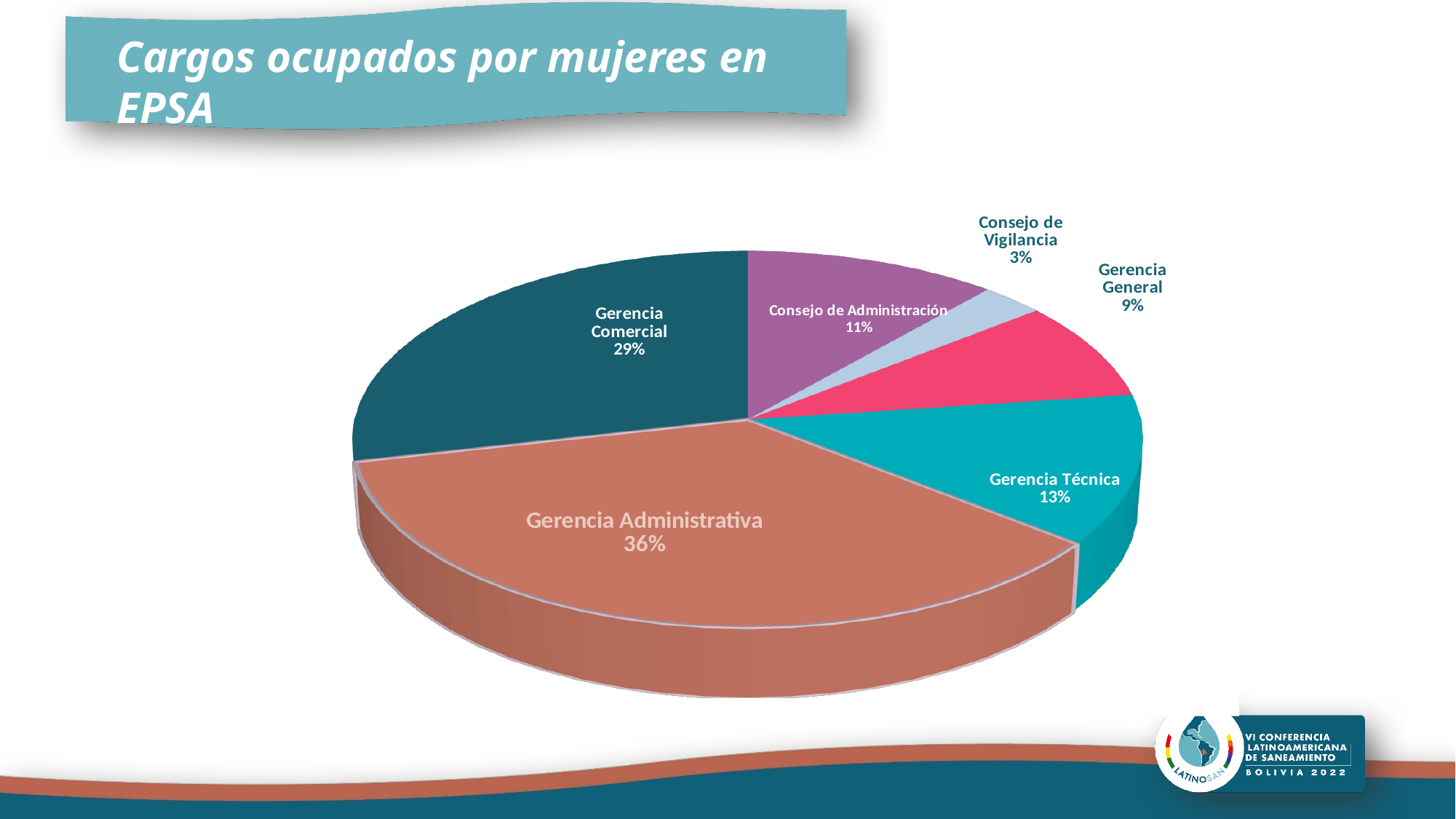
How many slices does the pie chart have? 6 Which is larger, the share for Gerencia Técnica or the share for Gerencia General? Gerencia Técnica What is the value shown for Consejo de Administración? 11% Which category has the smallest slice of the pie? Consejo de Vigilancia What is the title of the slide containing the chart? Cargos ocupados por mujeres en EPSA What kind of chart is shown on the slide? pie chart Which category has the largest slice of the pie? Gerencia Administrativa What is the difference between the shares of Gerencia Administrativa and Gerencia Comercial? 7% What is the value shown for Gerencia Comercial? 29% What is the value shown for Gerencia General? 9% What is the value shown for Gerencia Técnica? 13% What share of the pie does Gerencia Administrativa hold? 36%